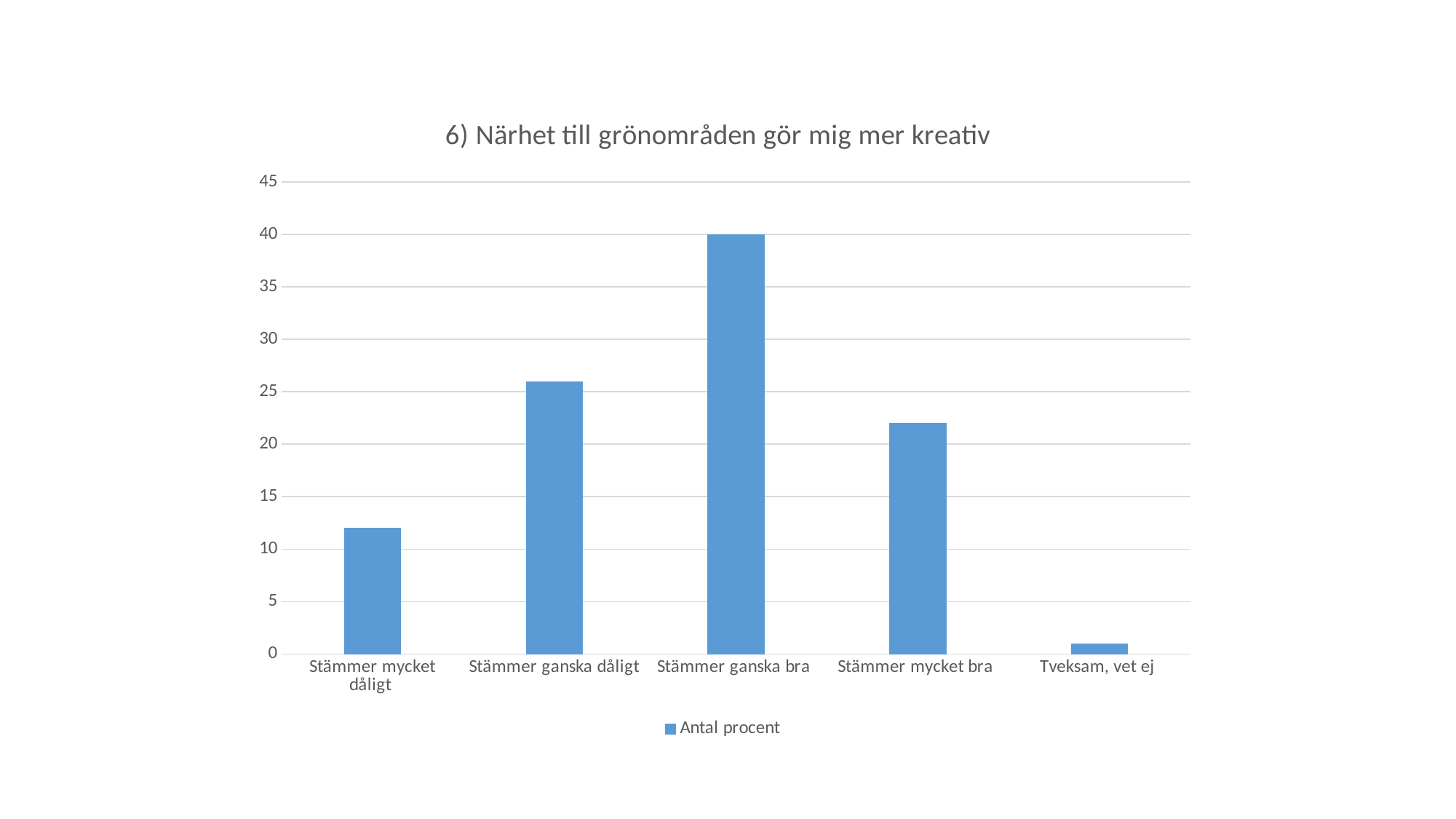
How many series does the legend list? 1 Is the value for Stämmer mycket bra greater or less than 20? greater Is the value for Stämmer ganska dåligt greater or less than 25? greater Which category has the lowest value? Tveksam, vet ej What is the name of the series in the legend? Antal procent What is the value for Stämmer ganska bra? 40 Is the value for Stämmer mycket dåligt greater or less than 15? less Which is larger, the value for Stämmer ganska dåligt or the value for Stämmer mycket bra? Stämmer ganska dåligt What is the title of the chart? 6) Närhet till grönområden gör mig mer kreativ How many categories are shown on the x axis? 5 What type of chart is shown on the slide? bar chart Which category has the highest value? Stämmer ganska bra